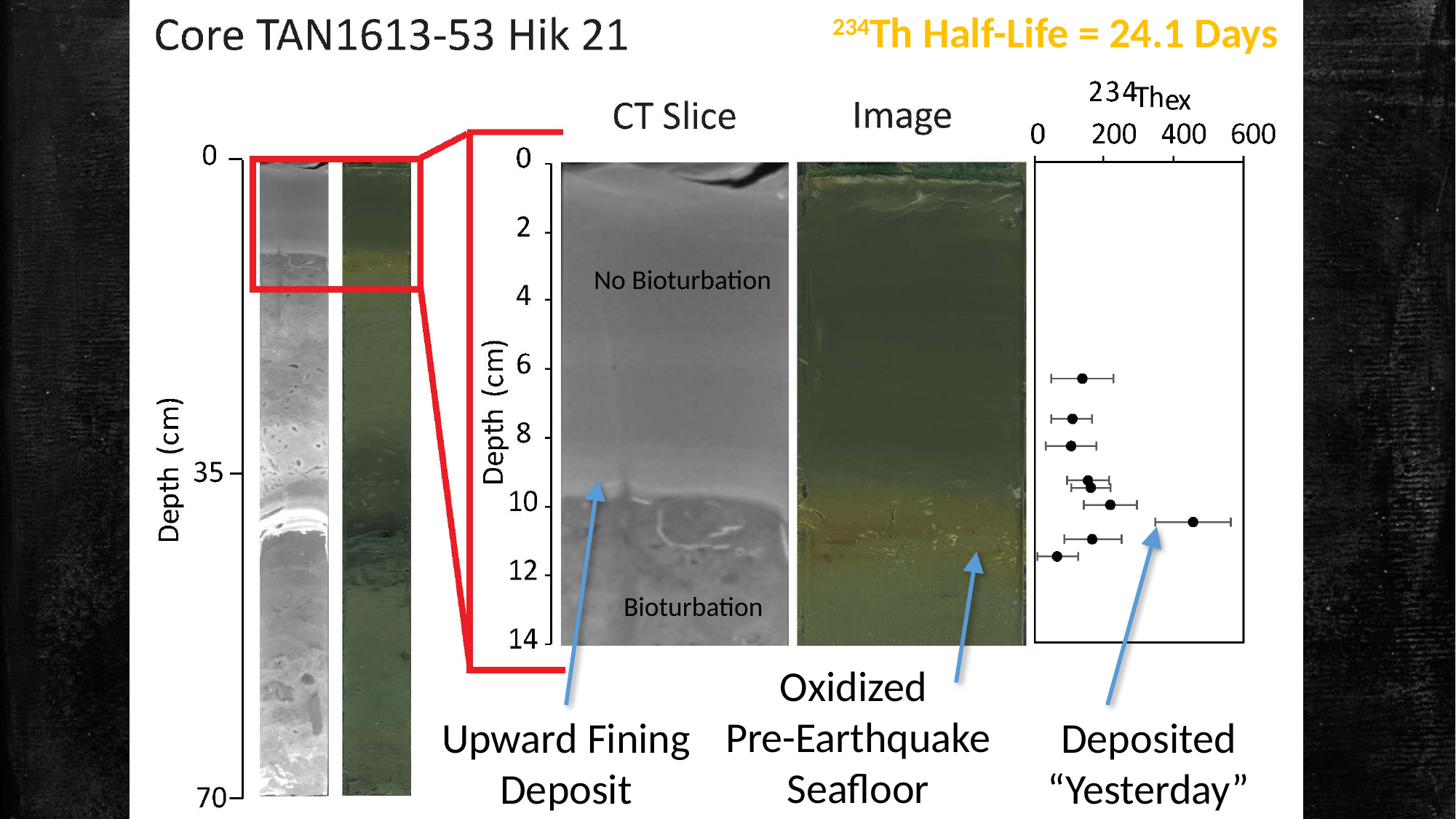
What kind of chart is the 234Thex plot on the right of the slide? scatter plot with error bars In the 234Thex chart, is the value of the shallowest point (about 6 cm depth) greater or less than 200? less In the 234Thex chart, what is the deepest depth tick shown on the vertical axis? 14 In the 234Thex chart, which point has the larger value: the one at about 10.5 cm depth or the one at about 11.5 cm depth? the one at about 10.5 cm In the 234Thex chart, is the value of the point at about 10.5 cm depth greater or less than 400? greater In the 234Thex chart, is the value of the deepest point (about 11.5 cm) greater or less than 100? less In the 234Thex chart, which point has the larger value: the one at about 10 cm depth or the one at about 7.5 cm depth? the one at about 10 cm In the 234Thex chart, what is the label of the vertical axis? Depth (cm) In the 234Thex chart, what is the highest value shown on the horizontal axis? 600